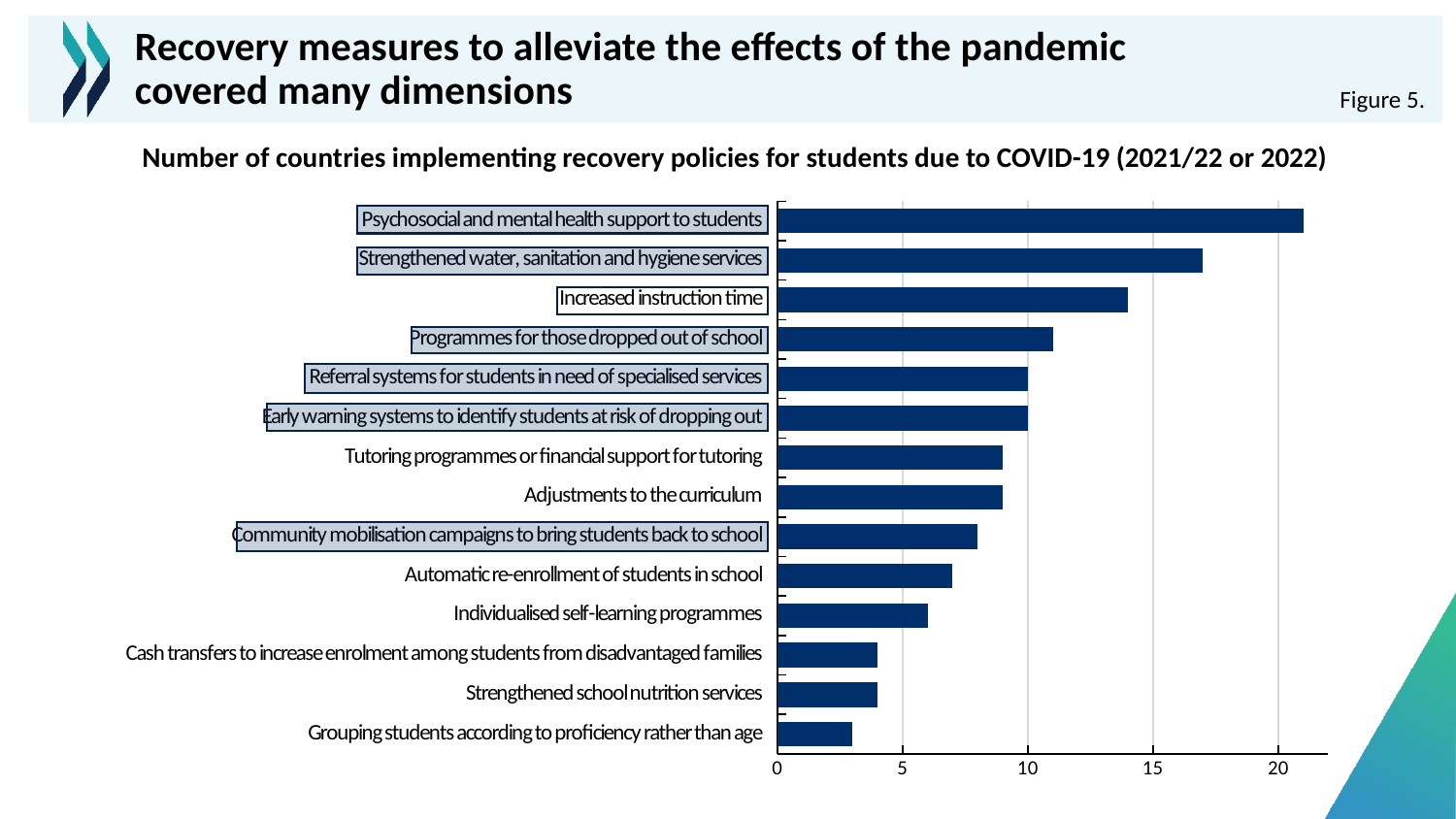
What kind of chart is shown on the slide? bar chart Is the value for 'Strengthened school nutrition services' greater or less than 5? less Is the value for 'Psychosocial and mental health support to students' greater or less than 20? greater Is the value for 'Individualised self-learning programmes' greater or less than 5? greater Which recovery policy was implemented by the fewest countries? Grouping students according to proficiency rather than age Which has a lower value: 'Community mobilisation campaigns to bring students back to school' or 'Increased instruction time'? Community mobilisation campaigns to bring students back to school How many recovery policies (categories) are listed in the chart? 14 Which has a higher value: 'Programmes for those dropped out of school' or 'Automatic re-enrollment of students in school'? Programmes for those dropped out of school What is the title of the chart? Number of countries implementing recovery policies for students due to COVID-19 (2021/22 or 2022) Which recovery policy was implemented by the largest number of countries? Psychosocial and mental health support to students